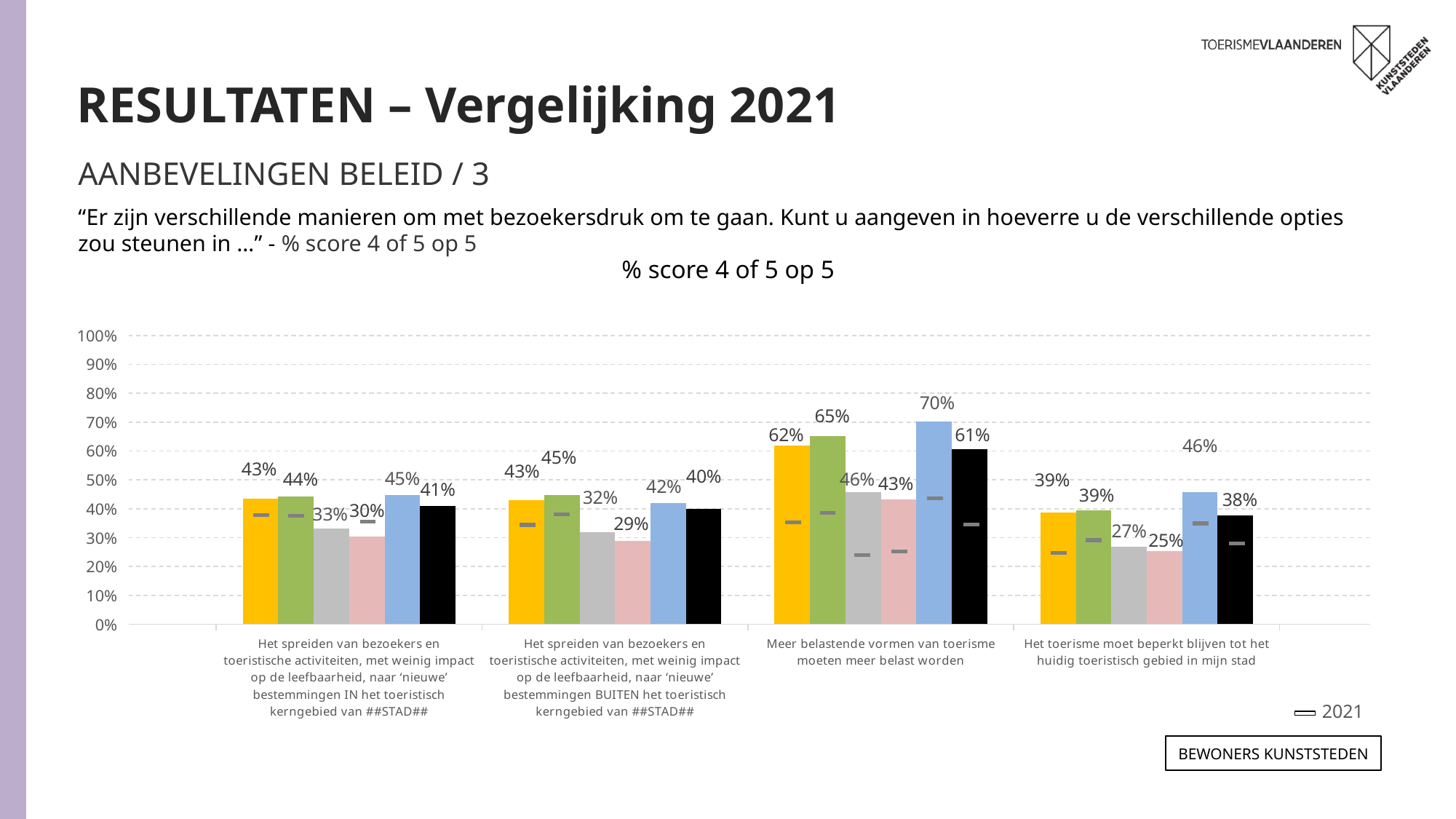
What is the lowest labelled value in the category 'Het spreiden van bezoekers en toeristische activiteiten ... IN het toeristisch kerngebied van ##STAD##'? 30% What is the difference between the highest and lowest labelled values in the category 'Meer belastende vormen van toerisme moeten meer belast worden'? 27 percentage points Which is larger: the tallest bar in 'Meer belastende vormen van toerisme moeten meer belast worden' or the tallest bar in 'Het toerisme moet beperkt blijven tot het huidig toeristisch gebied in mijn stad'? Meer belastende vormen van toerisme moeten meer belast worden Is the tallest bar in 'Meer belastende vormen van toerisme moeten meer belast worden' greater or less than 80%? less In which category does the highest labelled value (70%) appear? Meer belastende vormen van toerisme moeten meer belast worden What year does the dash marker in the chart legend represent? 2021 What kind of chart is shown on the slide? bar chart What is the title of the chart? % score 4 of 5 op 5 How many categories are shown along the x axis of the chart? 4 What is the lowest value labelled anywhere in the chart? 25% How many bars are plotted for each category in the chart? 6 What is the highest value labelled anywhere in the chart? 70%